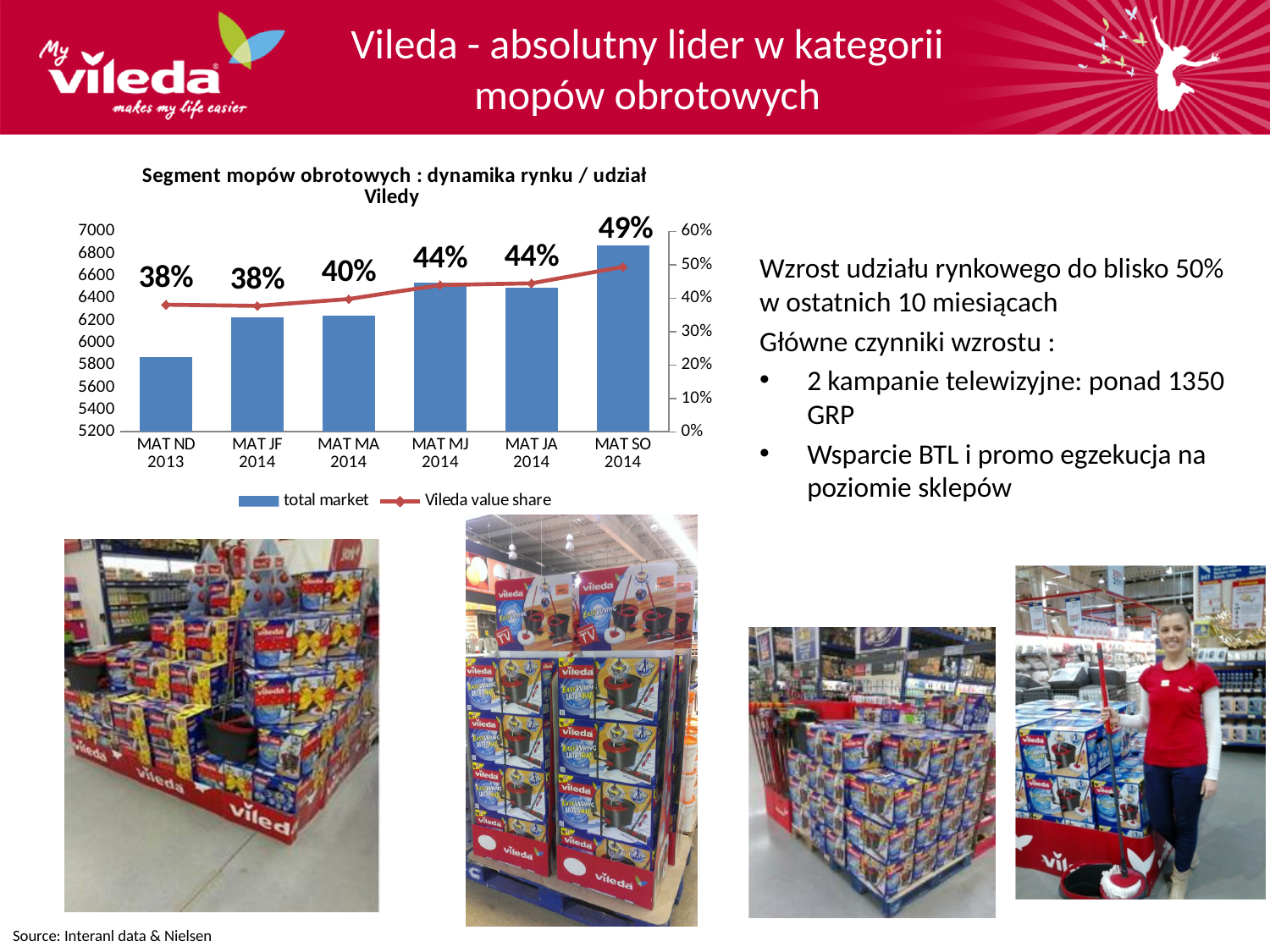
What is the Vileda value share for MAT MA 2014? 40% What is the Vileda value share for MAT SO 2014? 49% Is the total market value for MAT SO 2014 greater or less than 6600? greater What is the Vileda value share for MAT ND 2013? 38% Which period has the highest Vileda value share? MAT SO 2014 How many series does the chart legend list? 2 Does the Vileda value share rise or fall from MAT ND 2013 to MAT SO 2014? rise How many periods are shown on the x axis of the chart? 6 Is the total market value for MAT ND 2013 greater or less than 6000? less Which period has the largest total market bar? MAT SO 2014 By how many percentage points did the Vileda value share change from MAT ND 2013 to MAT SO 2014? 11 percentage points Which period has the smallest total market bar? MAT ND 2013